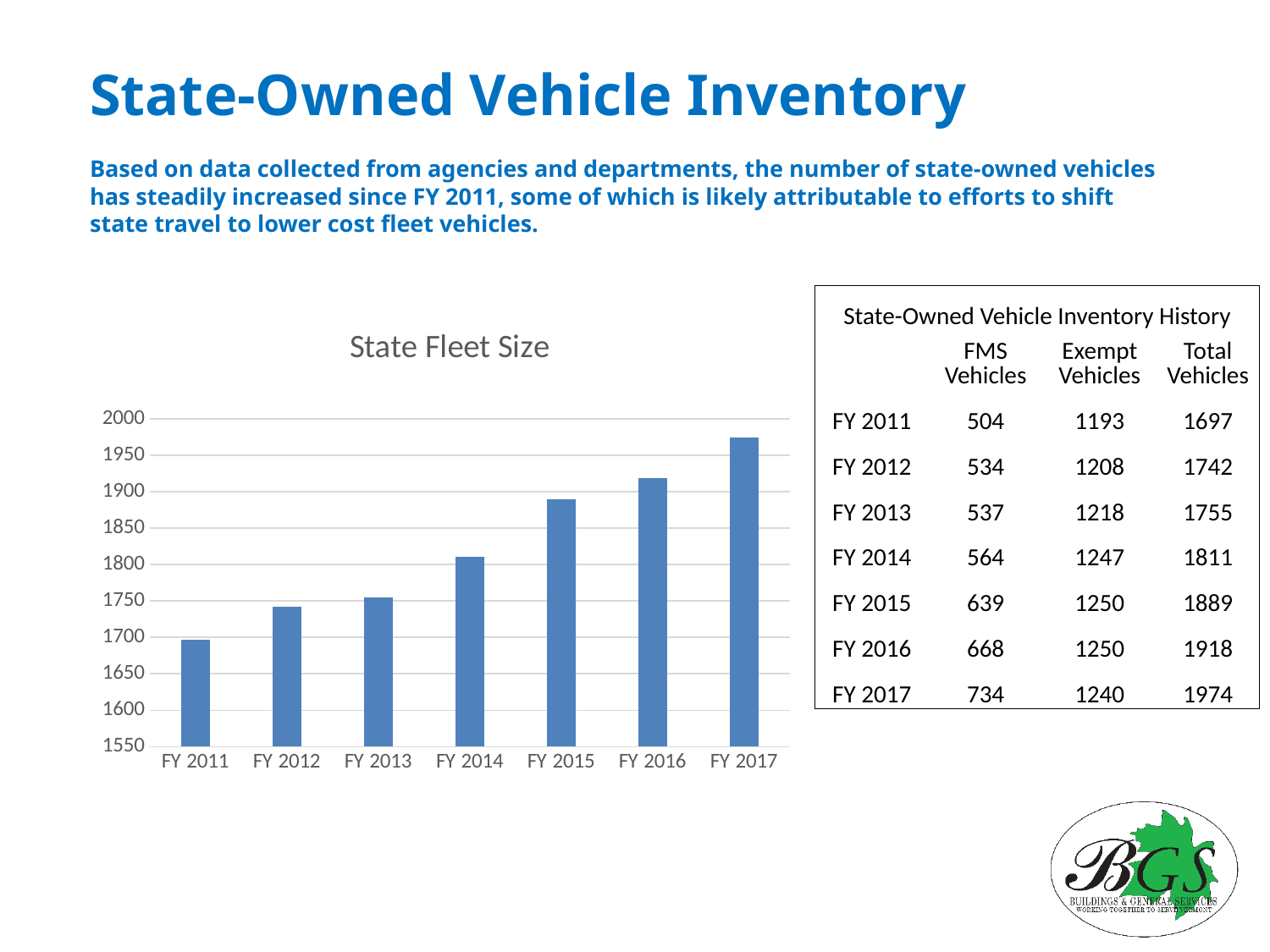
Is the value for FY 2014 in the State Fleet Size chart greater or less than 1800? greater According to the slide, what is the total number of state-owned vehicles plotted for FY 2011 in the State Fleet Size chart? 1697 What kind of chart is the State Fleet Size chart? bar chart Is the value for FY 2012 in the State Fleet Size chart greater or less than 1750? less Which fiscal year has the tallest bar in the State Fleet Size chart? FY 2017 How many fiscal years are shown on the x axis of the State Fleet Size chart? 7 Using the totals printed on the slide, by how much did the state fleet size grow from FY 2011 to FY 2017? 277 According to the slide, what is the total number of state-owned vehicles plotted for FY 2015 in the State Fleet Size chart? 1889 Is the value for FY 2017 in the State Fleet Size chart greater or less than 1950? greater Which is larger in the State Fleet Size chart, the bar for FY 2013 or the bar for FY 2016? FY 2016 Which fiscal year has the shortest bar in the State Fleet Size chart? FY 2011 Do the values in the State Fleet Size chart rise or fall from FY 2011 to FY 2017? rise